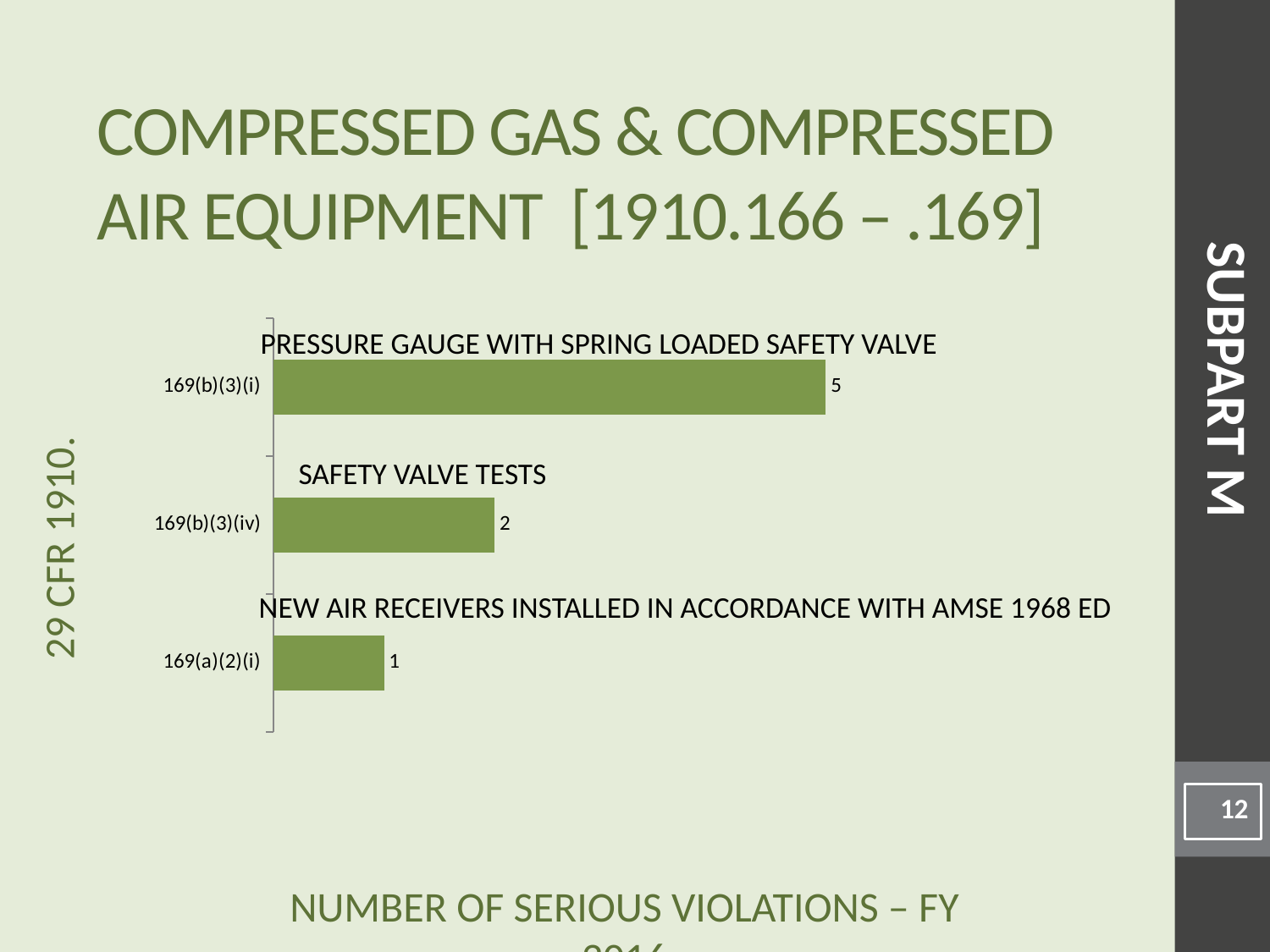
Which is larger, the value for 169(b)(3)(iv) or the value for 169(a)(2)(i)? 169(b)(3)(iv) What is the total of all values shown in the chart? 8 What is the value for 169(b)(3)(i)? 5 What is the difference between the values for 169(b)(3)(i) and 169(b)(3)(iv)? 3 What kind of chart is shown on the slide? Bar chart Which category has the highest number of serious violations? 169(b)(3)(i) Which category has the lowest number of serious violations? 169(a)(2)(i) What is the value for 169(b)(3)(iv)? 2 What description is shown above the bar for 169(b)(3)(iv)? SAFETY VALVE TESTS How many categories are shown in the chart? 3 What is the difference between the values for 169(b)(3)(iv) and 169(a)(2)(i)? 1 What is the value for 169(a)(2)(i)? 1